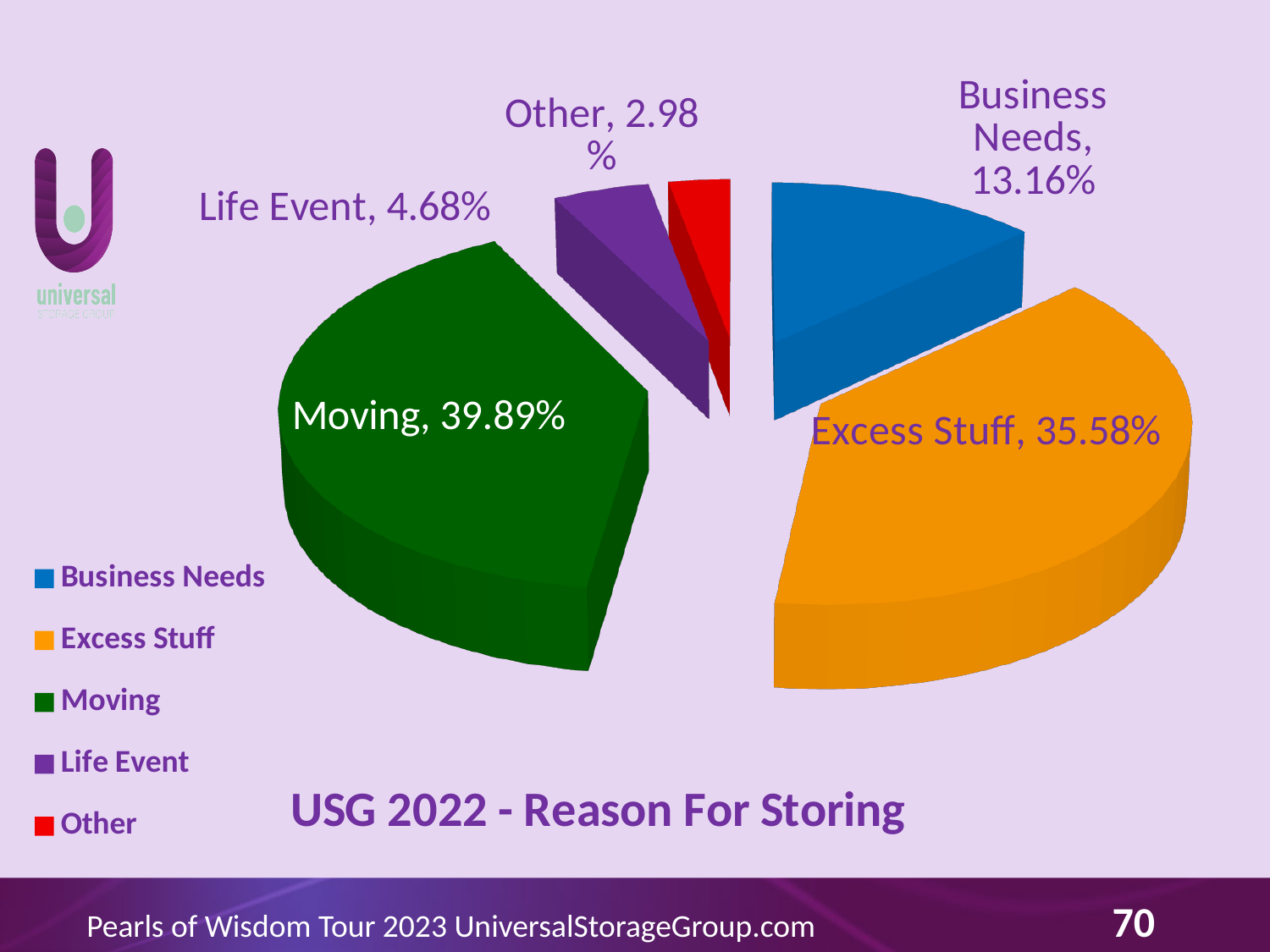
What is the difference in percentage points between Moving and Excess Stuff? 4.31 Which reason for storing has the smallest share? Other Which reason for storing has the largest share? Moving What percentage of the pie is Moving? 39.89% What is the title of the chart? USG 2022 - Reason For Storing What percentage of the pie is Other? 2.98% How many slices does the pie chart have? 5 Which colour represents Excess Stuff in the legend? Orange What percentage of the pie is Business Needs? 13.16% What type of chart is shown on the slide? Pie chart What percentage of the pie is Excess Stuff? 35.58% What percentage of the pie is Life Event? 4.68%